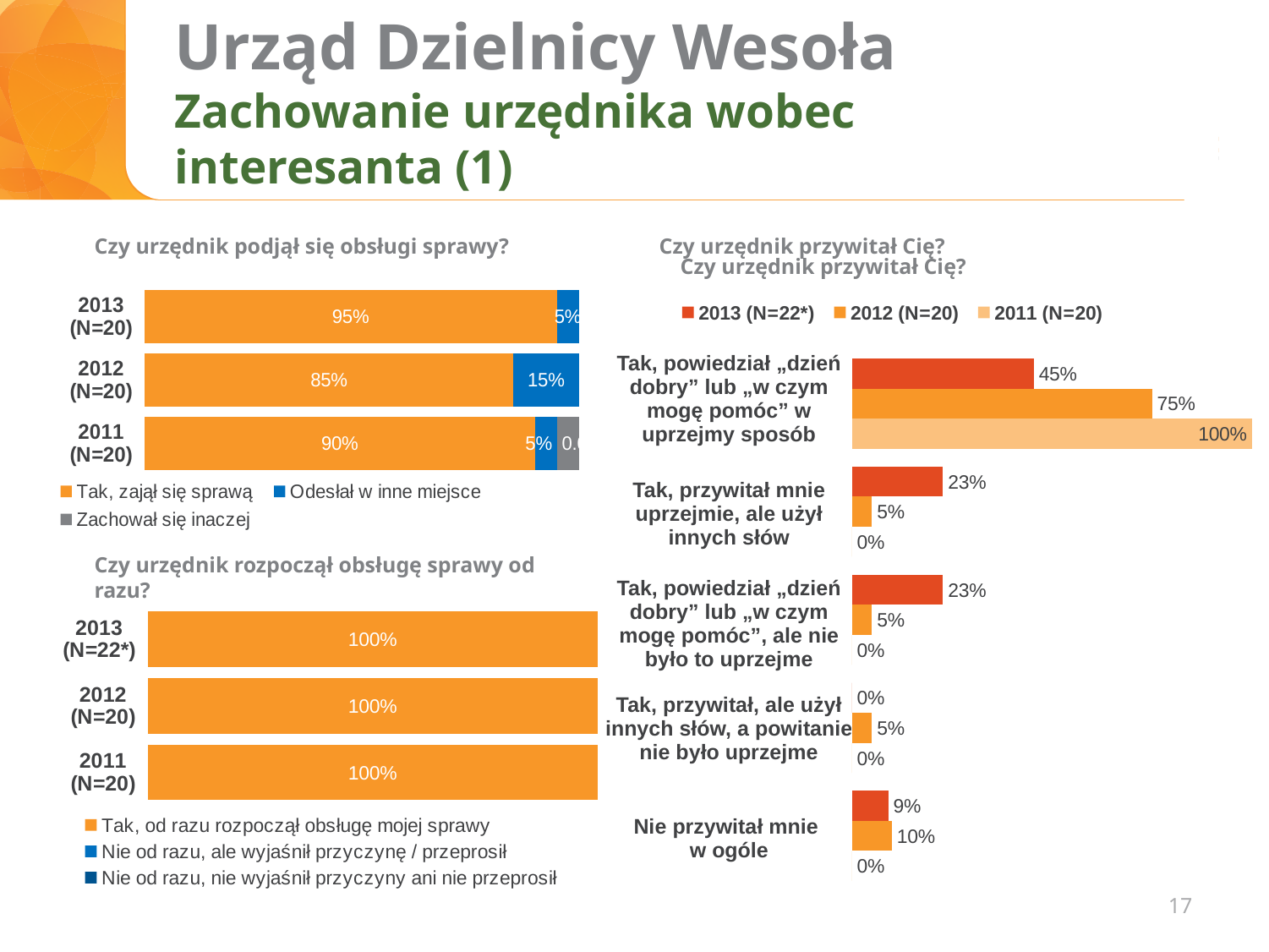
In the chart 'Czy urzędnik rozpoczął obsługę sprawy od razu?', what is the value for 'Tak, od razu rozpoczął obsługę mojej sprawy' in 2011 (N=20)? 100% In the chart 'Czy urzędnik przywitał Cię?', what is the 2013 (N=22*) value for 'Nie przywitał mnie w ogóle'? 9% In the chart 'Czy urzędnik podjął się obsługi sprawy?', what is the difference between the 'Tak, zajął się sprawą' values for 2013 and 2012? 10% In the chart 'Czy urzędnik przywitał Cię?', which year has the highest value for 'Tak, powiedział „dzień dobry” lub „w czym mogę pomóc” w uprzejmy sposób'? 2011 (N=20) In the chart 'Czy urzędnik podjął się obsługi sprawy?', what is the value for 'Tak, zajął się sprawą' in 2013 (N=20)? 95% In the chart 'Czy urzędnik przywitał Cię?', how many categories are shown? 5 In the chart 'Czy urzędnik przywitał Cię?', what is the 2012 (N=20) value for 'Tak, powiedział „dzień dobry” lub „w czym mogę pomóc” w uprzejmy sposób'? 75% What type of chart is 'Czy urzędnik przywitał Cię?'? bar chart In the chart 'Czy urzędnik przywitał Cię?', is the 2013 (N=22*) value for 'Tak, przywitał mnie uprzejmie, ale użył innych słów' larger or smaller than the 2012 (N=20) value? larger In the chart 'Czy urzędnik podjął się obsługi sprawy?', what is the value for 'Odesłał w inne miejsce' in 2012 (N=20)? 15% How many legend entries does the chart 'Czy urzędnik rozpoczął obsługę sprawy od razu?' list? 3 In the chart 'Czy urzędnik podjął się obsługi sprawy?', which year has the lowest value for 'Tak, zajął się sprawą'? 2012 (N=20)